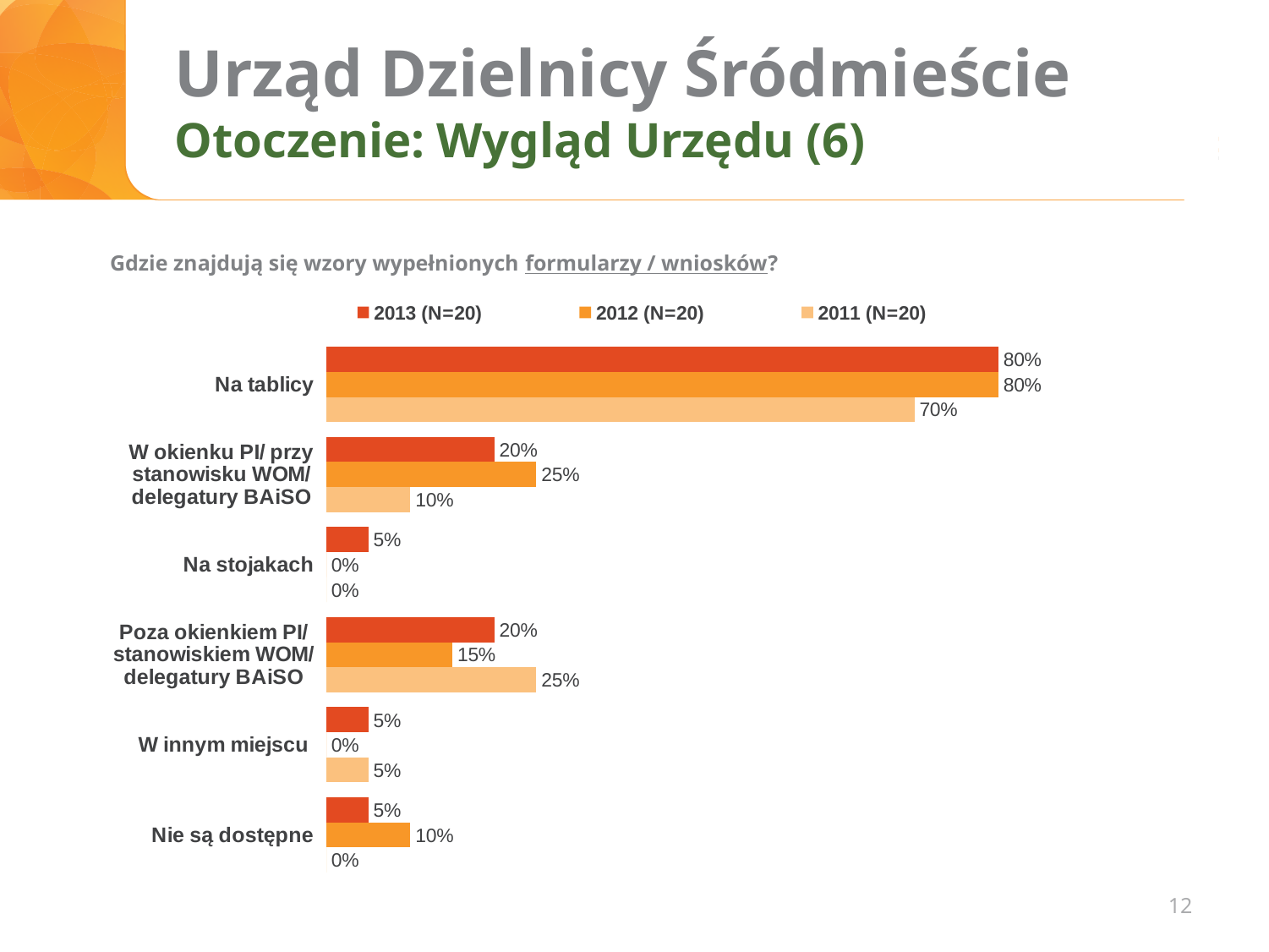
How many categories are shown on the chart? 6 What is the value for "W okienku PI/ przy stanowisku WOM/ delegatury BAiSO" in the 2012 (N=20) series? 25% For "W okienku PI/ przy stanowisku WOM/ delegatury BAiSO", which is larger: the 2013 (N=20) value or the 2012 (N=20) value? 2012 (N=20) Which category has the highest value in the 2011 (N=20) series? Na tablicy What is the difference between the 2013 (N=20) and 2011 (N=20) values for "Na tablicy"? 10% What kind of chart is shown on the slide? Bar chart How many series does the legend list? 3 Which category has the highest value in the 2013 (N=20) series? Na tablicy What is the value for "Nie są dostępne" in the 2012 (N=20) series? 10% What is the value for "Na tablicy" in the 2013 (N=20) series? 80% What is the value for "Na tablicy" in the 2011 (N=20) series? 70% What is the difference between the 2011 (N=20) and 2012 (N=20) values for "Poza okienkiem PI/ stanowiskiem WOM/ delegatury BAiSO"? 10%